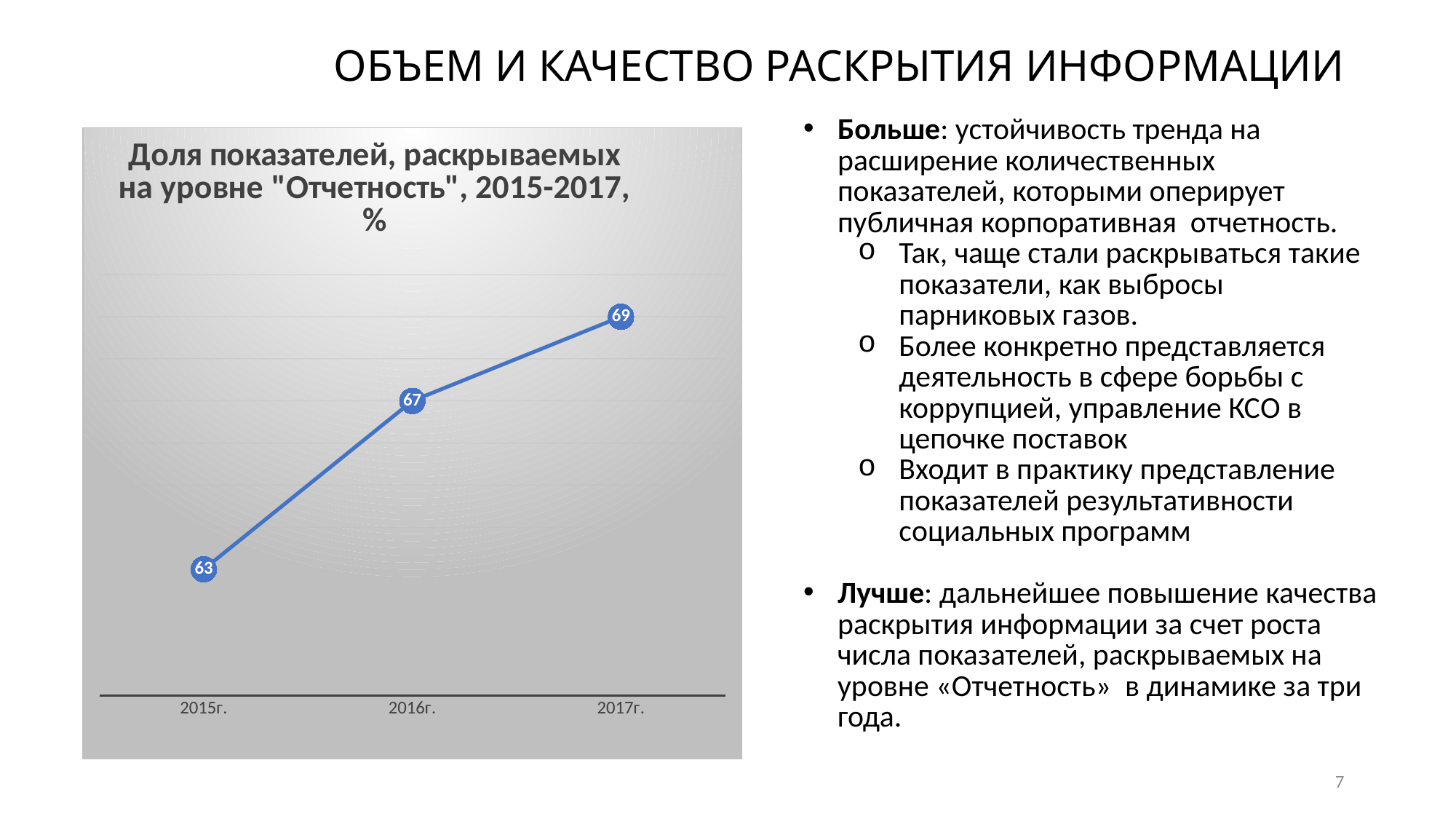
What kind of chart is shown on the slide? line chart What is the difference between the values for 2016г. and 2015г.? 4 How many data points are plotted on the chart? 3 Which year has the lowest value? 2015г. What is the value for 2017г.? 69 What is the value for 2016г.? 67 Which year has the highest value? 2017г. Do the values rise or fall from 2015г. to 2017г.? rise What is the title of the chart? Доля показателей, раскрываемых на уровне "Отчетность", 2015-2017, % What is the value for 2015г.? 63 What is the difference between the values for 2017г. and 2015г.? 6 Which is larger, the value for 2016г. or the value for 2017г.? 2017г.